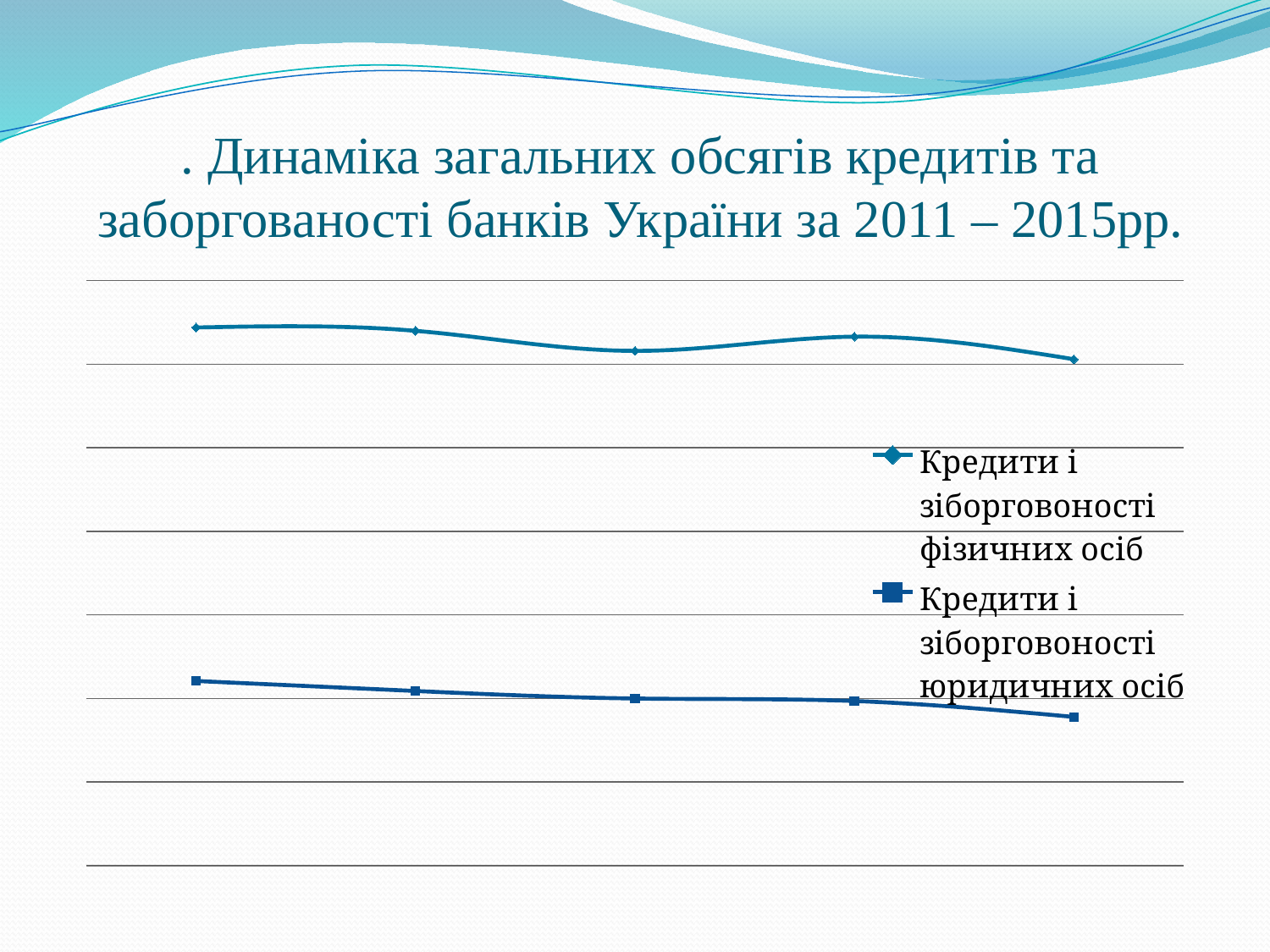
How many series does the legend list? 2 How many data points are plotted for the series "Кредити і зіборговоності юридичних осіб"? 5 Do the values for "Кредити і зіборговоності юридичних осіб" generally rise or fall from left to right? fall What kind of chart is shown on the slide? line chart Which legend entry is shown with square markers? Кредити і зіборговоності юридичних осіб How many data points are plotted for the series "Кредити і зіборговоності фізичних осіб"? 5 Which series is plotted higher on the chart, "Кредити і зіборговоності фізичних осіб" or "Кредити і зіборговоності юридичних осіб"? Кредити і зіборговоності фізичних осіб What is the title of the chart on the slide? Динаміка загальних обсягів кредитів та заборгованості банків України за 2011 – 2015рр.